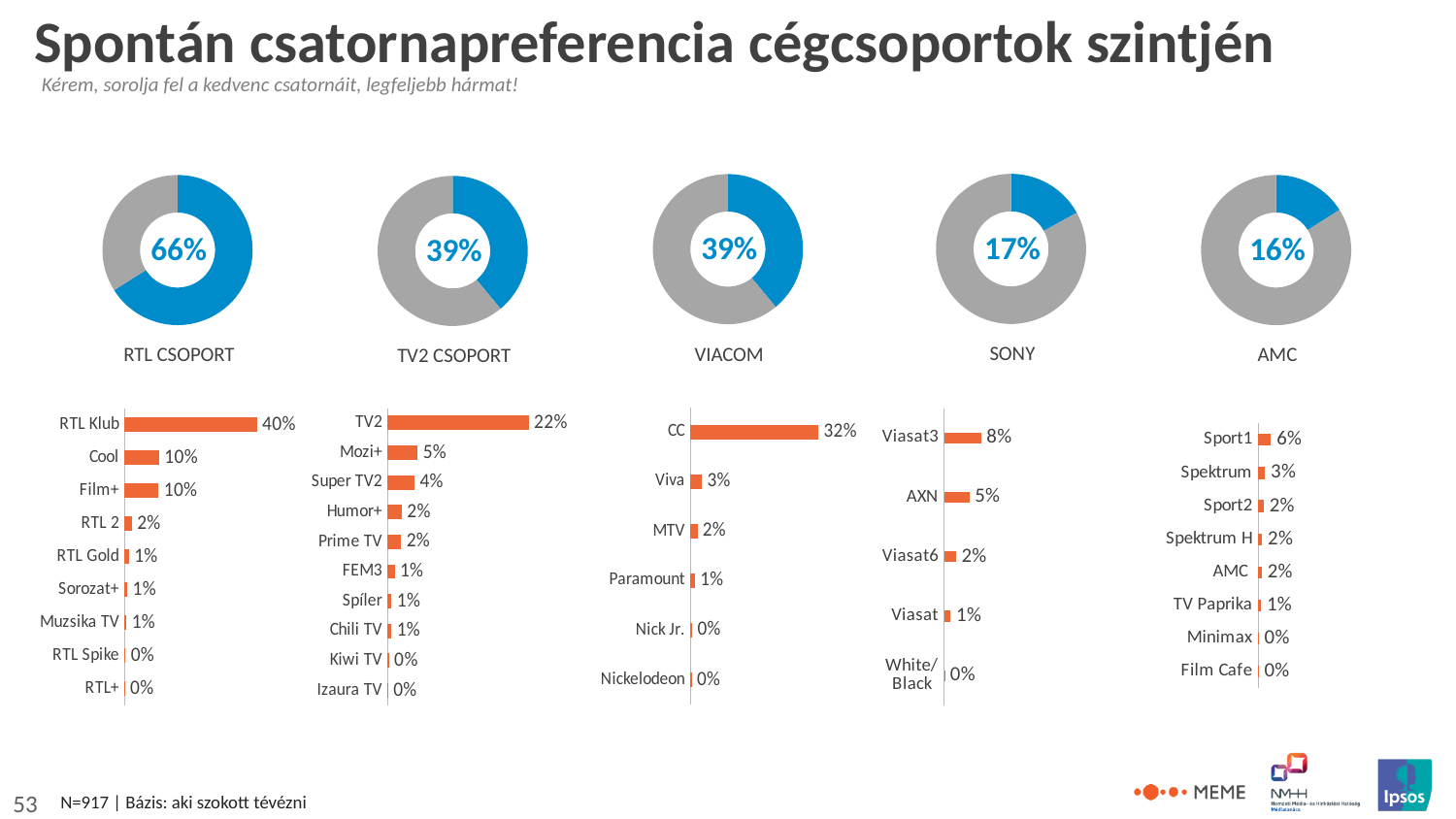
In the AMC bar chart, which is larger, Sport1 or Spektrum? Sport1 Among the five donut charts, which company group has the lowest percentage? AMC What is the difference between the RTL CSOPORT and TV2 CSOPORT donut chart percentages? 27% In the RTL CSOPORT bar chart, what is the value for RTL Klub? 40% In the SONY donut chart, what percentage is shown in the centre? 17% What kind of chart is used for the channel breakdown under each company group? Bar chart In the TV2 CSOPORT bar chart, what is the value for Mozi+? 5% In the RTL CSOPORT donut chart, what percentage is shown in the centre? 66% How many channels are listed in the TV2 CSOPORT bar chart? 10 In the SONY bar chart, what is the difference between Viasat3 and AXN? 3% How many channels are listed in the VIACOM bar chart? 6 In the VIACOM bar chart, which channel has the highest value? CC